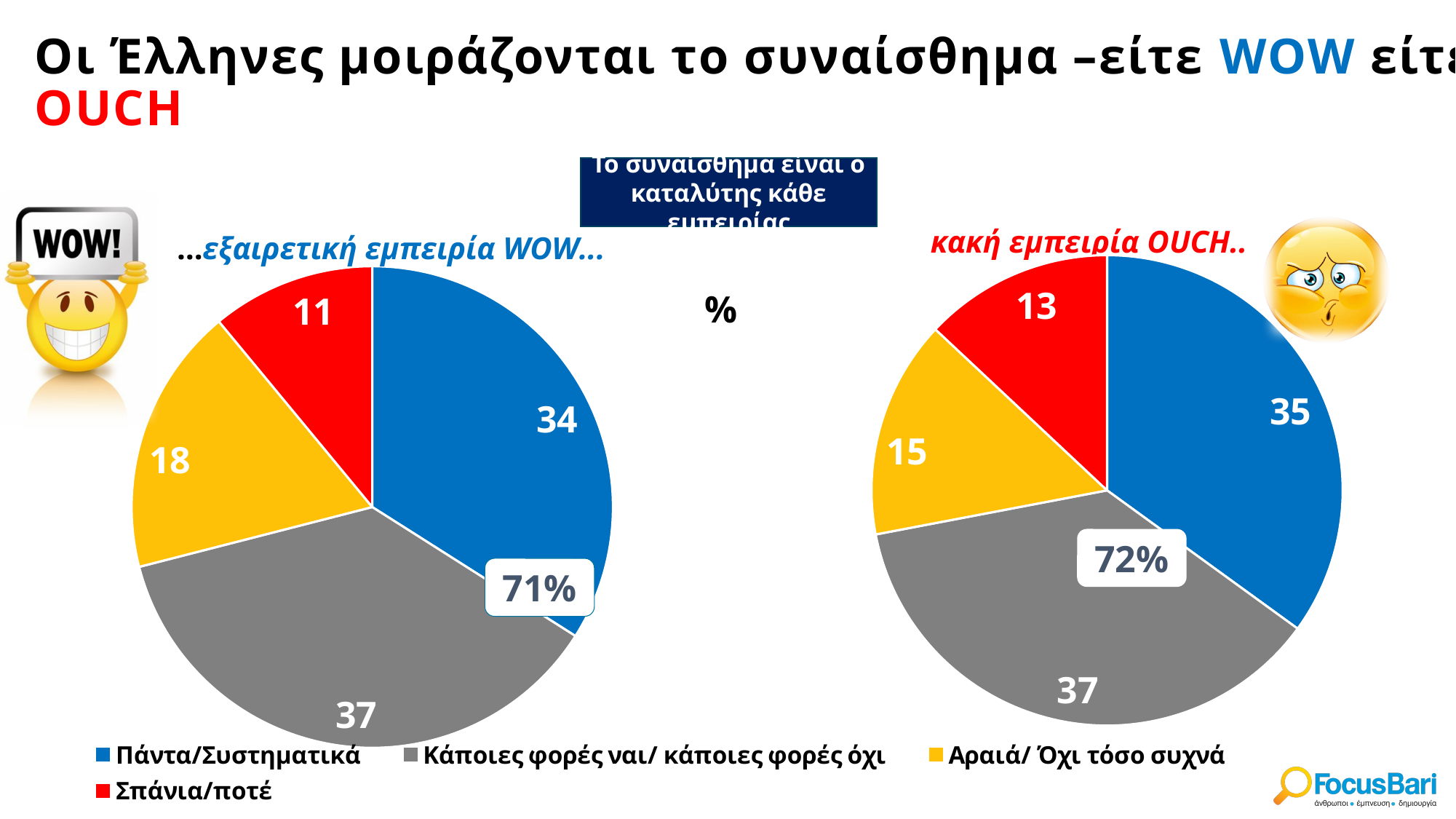
What type of chart is used on this slide? Pie chart In the OUCH pie chart (right), what is the value for Κάποιες φορές ναι/ κάποιες φορές όχι? 37 In the WOW pie chart (left), what is the value for Πάντα/Συστηματικά? 34 In the OUCH pie chart (right), what is the value for Αραιά/ Όχι τόσο συχνά? 15 What percentage is shown in the callout on the OUCH pie chart (right)? 72% In the WOW pie chart (left), what is the difference between Αραιά/ Όχι τόσο συχνά and Σπάνια/ποτέ? 7 In the WOW pie chart (left), which category has the largest slice? Κάποιες φορές ναι/ κάποιες φορές όχι In the OUCH pie chart (right), which category has the smallest slice? Σπάνια/ποτέ Which is larger: Πάντα/Συστηματικά in the WOW chart (left) or Πάντα/Συστηματικά in the OUCH chart (right)? OUCH chart (35) In the WOW pie chart (left), what is the value for Σπάνια/ποτέ? 11 How many slices does the OUCH pie chart (right) have? 4 How many entries does the legend list? 4